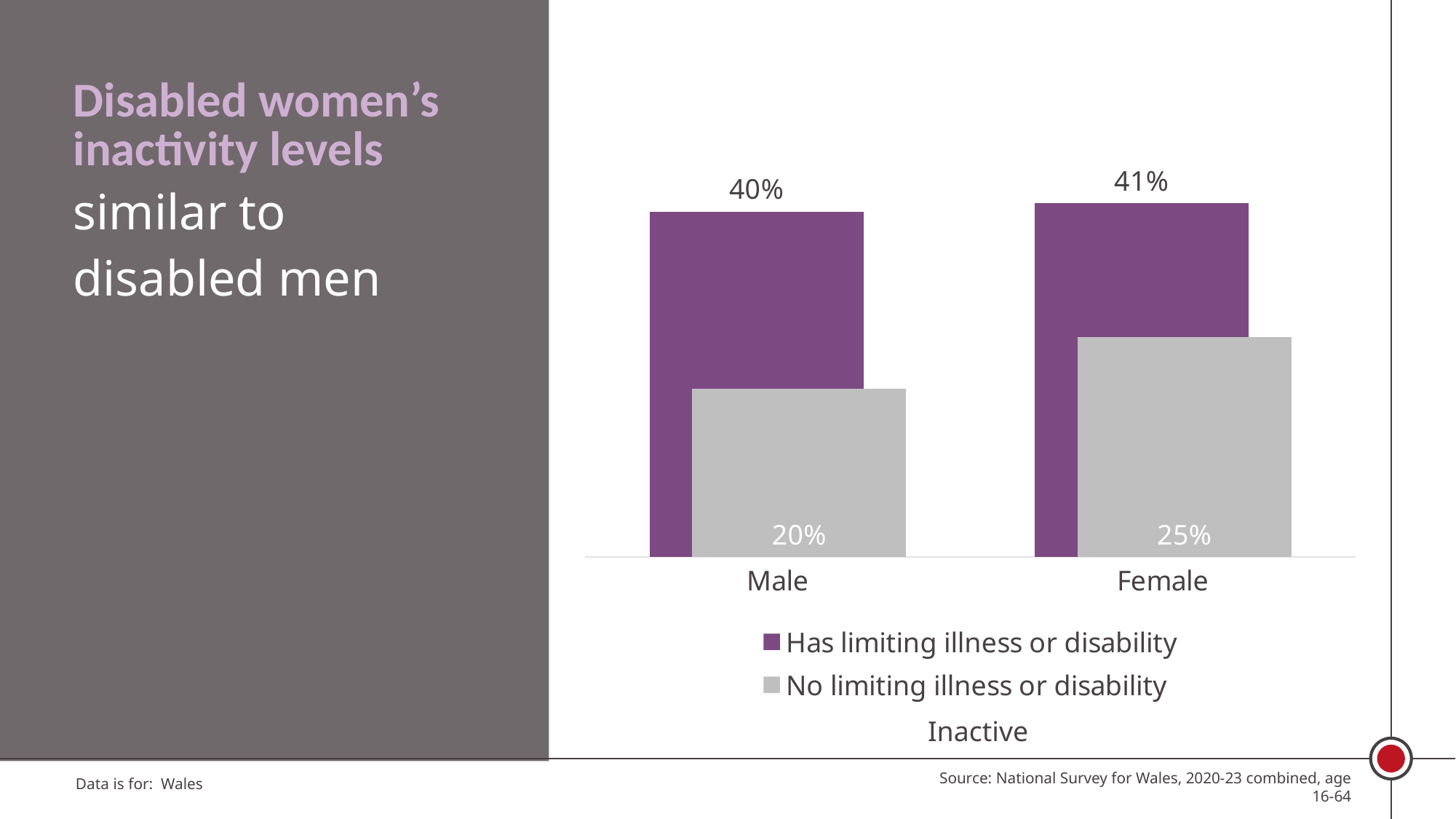
Which colour represents the 'Has limiting illness or disability' series in the chart? Purple What is the inactivity rate for males who have a limiting illness or disability? 40% What is the inactivity rate for males with no limiting illness or disability? 20% Which group has the lowest inactivity rate shown on the chart? Males with no limiting illness or disability What kind of chart is shown on the slide? Bar chart How many series does the chart legend list? 2 What is the inactivity rate for females with no limiting illness or disability? 25% What is the difference between the inactivity rates of females with and without a limiting illness or disability? 16 percentage points Which is larger: the inactivity rate for males with no limiting illness or disability, or for females with no limiting illness or disability? Females with no limiting illness or disability How many categories are shown on the x axis of the chart? 2 What is the inactivity rate for females who have a limiting illness or disability? 41% What is the difference between the inactivity rates of males with and without a limiting illness or disability? 20 percentage points